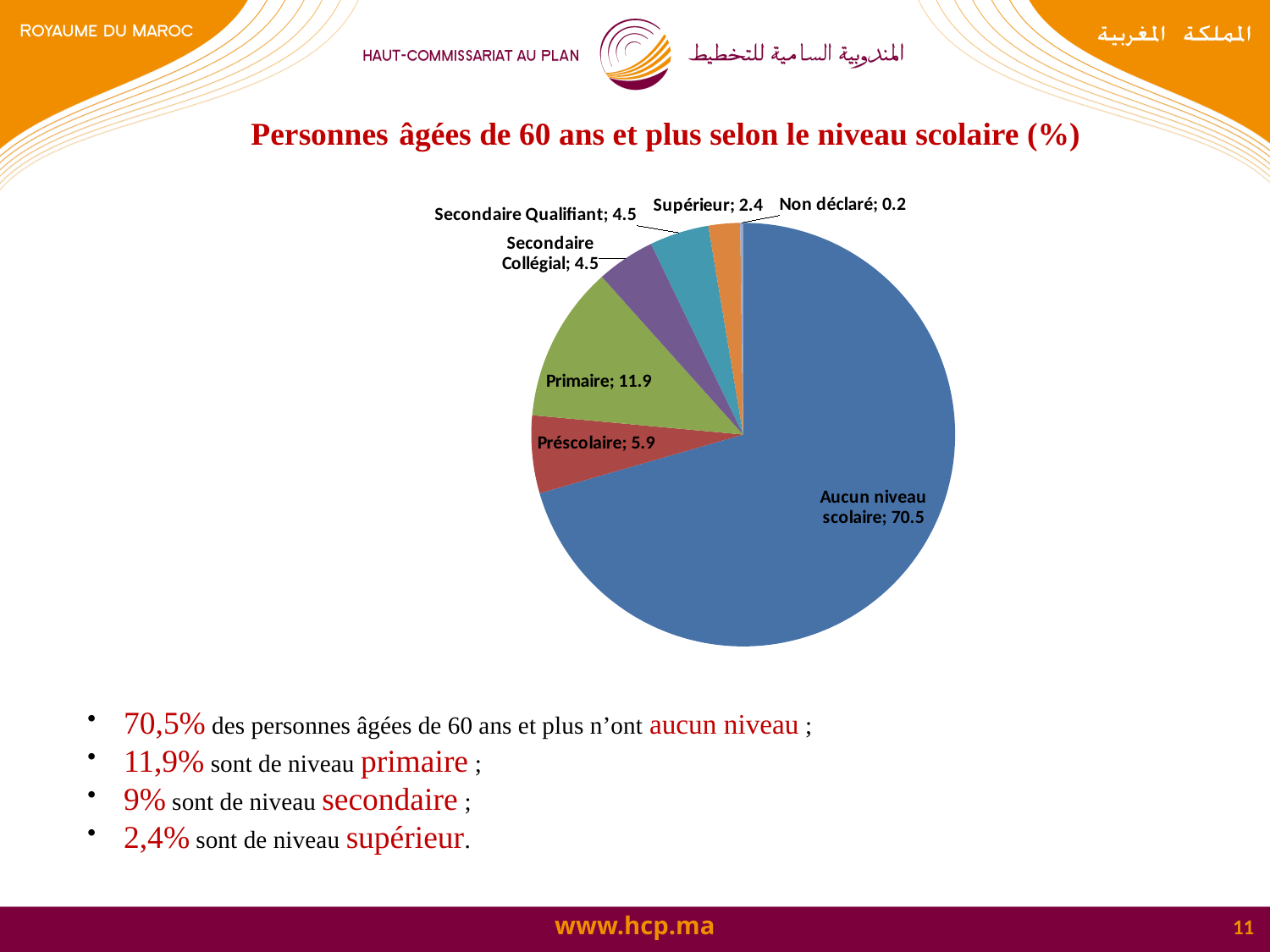
What is the value for 'Primaire' in the pie chart? 11.9 Which is larger, the value for 'Préscolaire' or the value for 'Secondaire Collégial'? Préscolaire What is the title of the chart on the slide? Personnes âgées de 60 ans et plus selon le niveau scolaire (%) What is the value for 'Préscolaire' in the pie chart? 5.9 What is the value for 'Non déclaré' in the pie chart? 0.2 What is the difference between the values for 'Primaire' and 'Préscolaire'? 6.0 Which category has the largest slice in the pie chart? Aucun niveau scolaire How many categories are shown in the pie chart? 7 What type of chart is shown on the slide? Pie chart What is the value for 'Supérieur' in the pie chart? 2.4 What is the value for 'Aucun niveau scolaire' in the pie chart? 70.5 Which category has the smallest slice in the pie chart? Non déclaré